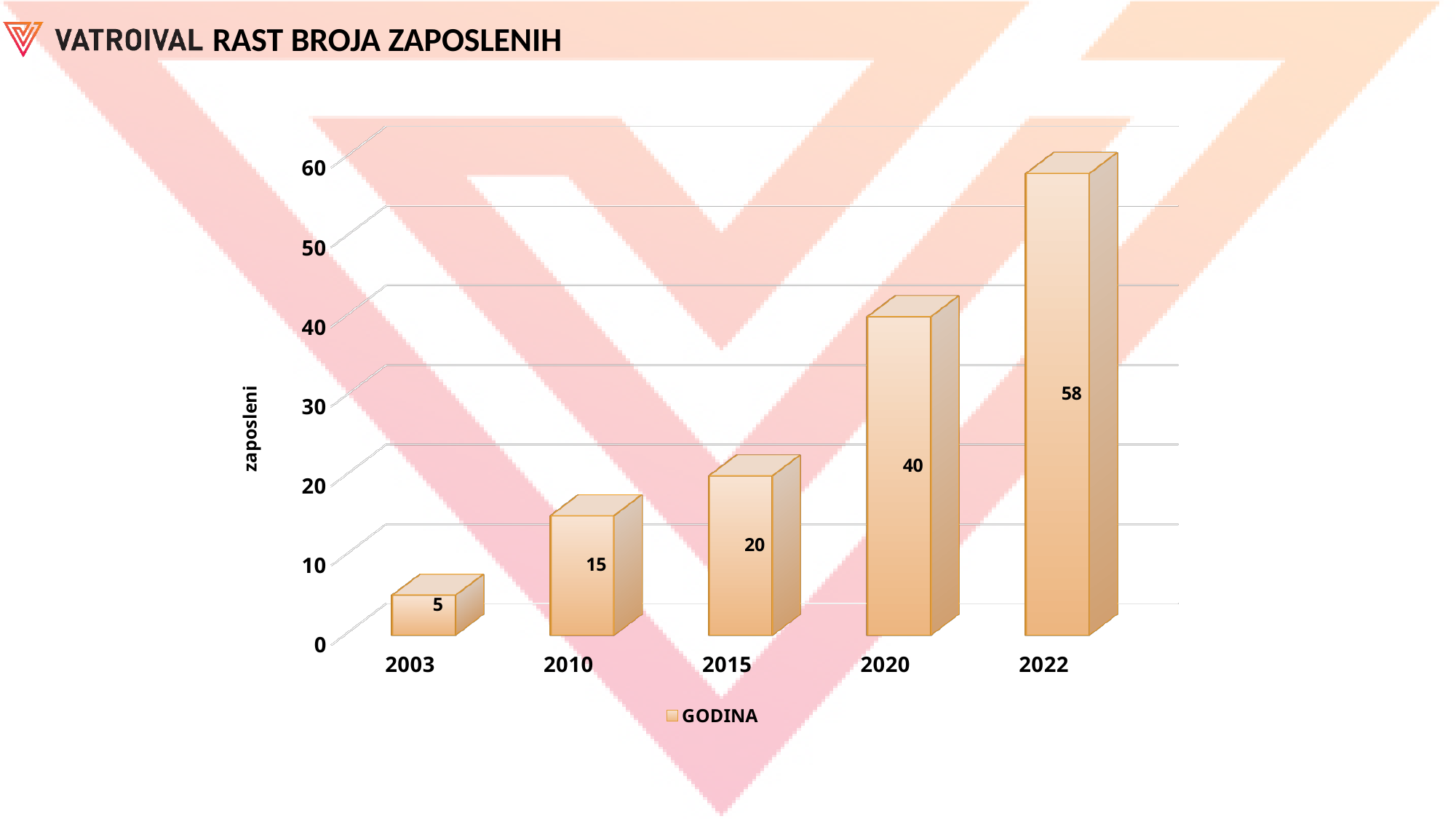
What is the difference between the values for 2022 and 2020? 18 What is the number of employees shown for 2015? 20 Which year has the highest number of employees? 2022 What is the number of employees shown for 2020? 40 How many years are shown on the x axis? 5 Which is larger, the value for 2015 or the value for 2010? 2015 What is the number of employees shown for 2022? 58 What kind of chart is shown on the slide? bar chart What is the number of employees shown for 2010? 15 Which year has the lowest number of employees? 2003 Do the values rise or fall from 2003 to 2022? rise What is the number of employees shown for 2003? 5